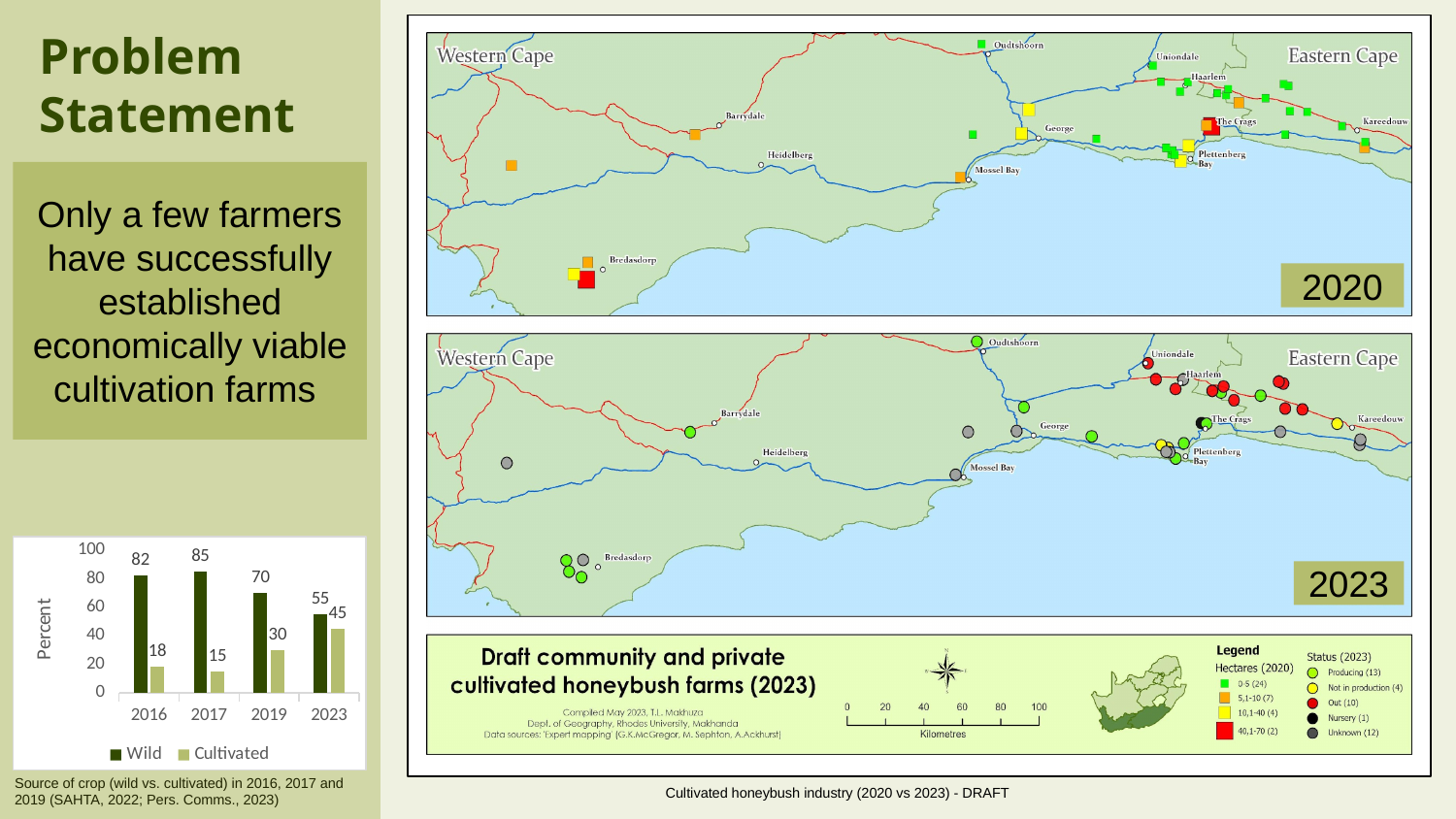
What is the difference between the Wild and Cultivated values in 2019? 40 How many series does the bar chart legend list? 2 In which year is the Wild value highest in the bar chart? 2017 In which year is the Cultivated value lowest in the bar chart? 2017 What is the Cultivated value for 2023 in the bar chart? 45 How many years are shown on the x axis of the bar chart? 4 What is the Wild value for 2016 in the bar chart? 82 Which is larger in 2023, the Wild value or the Cultivated value? Wild What kind of chart is shown at the bottom left of the slide? bar chart What is the Cultivated value for 2017 in the bar chart? 15 Does the Cultivated value rise or fall from 2017 to 2023 in the bar chart? rise What is the label on the y axis of the bar chart? Percent